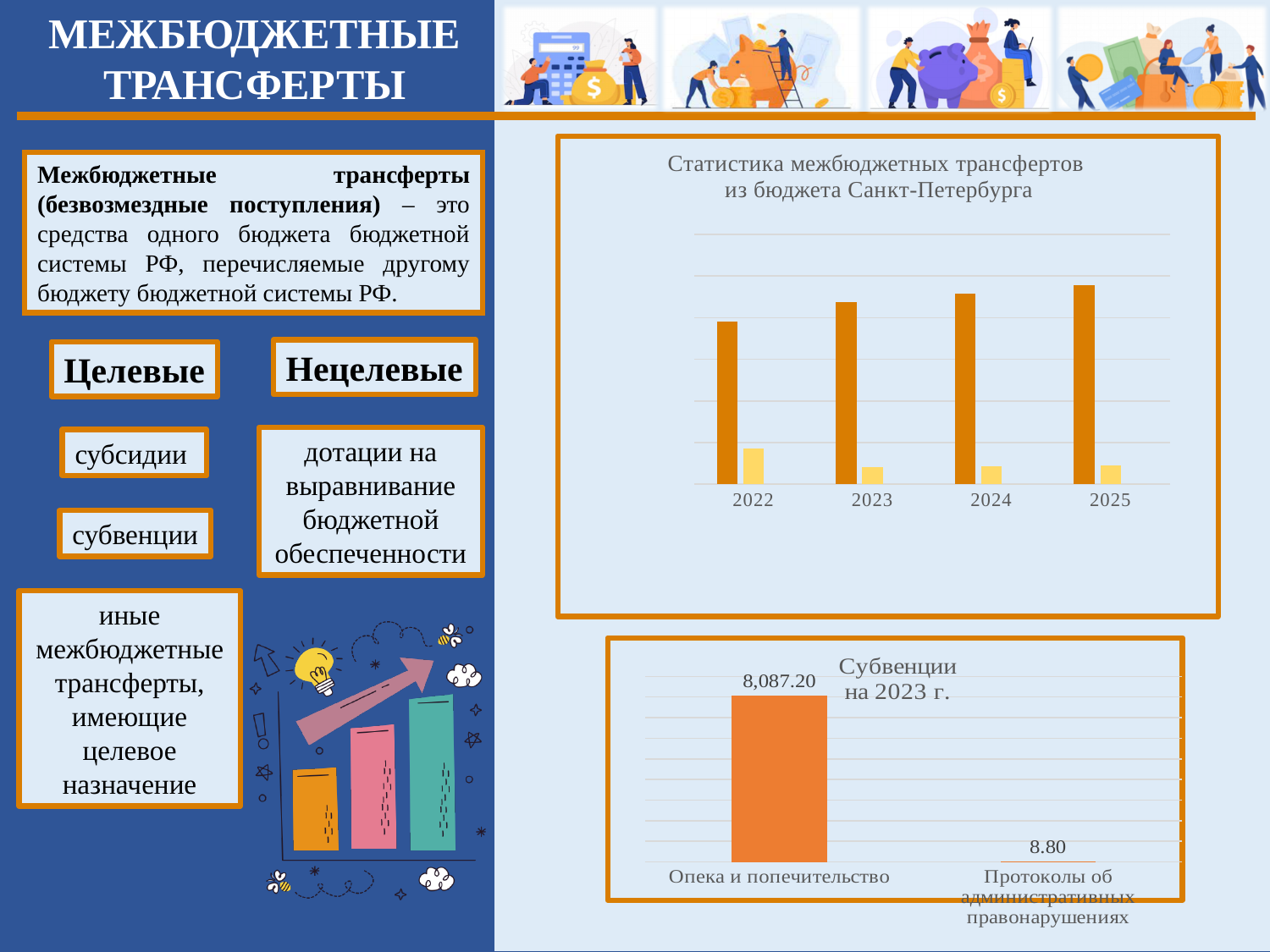
On the chart titled 'Субвенции на 2023 г.', what is the value for 'Опека и попечительство'? 8,087.20 On the chart titled 'Статистика межбюджетных трансфертов из бюджета Санкт-Петербурга', do the orange bars rise or fall from 2022 to 2025? Rise On the chart titled 'Статистика межбюджетных трансфертов из бюджета Санкт-Петербурга', how many years are shown on the x axis? 4 On the chart titled 'Субвенции на 2023 г.', which category has the highest value? Опека и попечительство On the chart titled 'Субвенции на 2023 г.', what is the difference between the values for 'Опека и попечительство' and 'Протоколы об административных правонарушениях'? 8,078.40 On the chart titled 'Статистика межбюджетных трансфертов из бюджета Санкт-Петербурга', in 2022, which bar is taller: the orange one or the yellow one? The orange one What kind of chart is the chart titled 'Субвенции на 2023 г.'? Bar chart On the chart titled 'Статистика межбюджетных трансфертов из бюджета Санкт-Петербурга', in which year is the orange bar the shortest? 2022 On the chart titled 'Субвенции на 2023 г.', which category has the lowest value? Протоколы об административных правонарушениях On the chart titled 'Субвенции на 2023 г.', what is the value for 'Протоколы об административных правонарушениях'? 8.80 On the chart titled 'Статистика межбюджетных трансфертов из бюджета Санкт-Петербурга', in which year is the orange bar the tallest? 2025 On the chart titled 'Субвенции на 2023 г.', how many categories are shown? 2